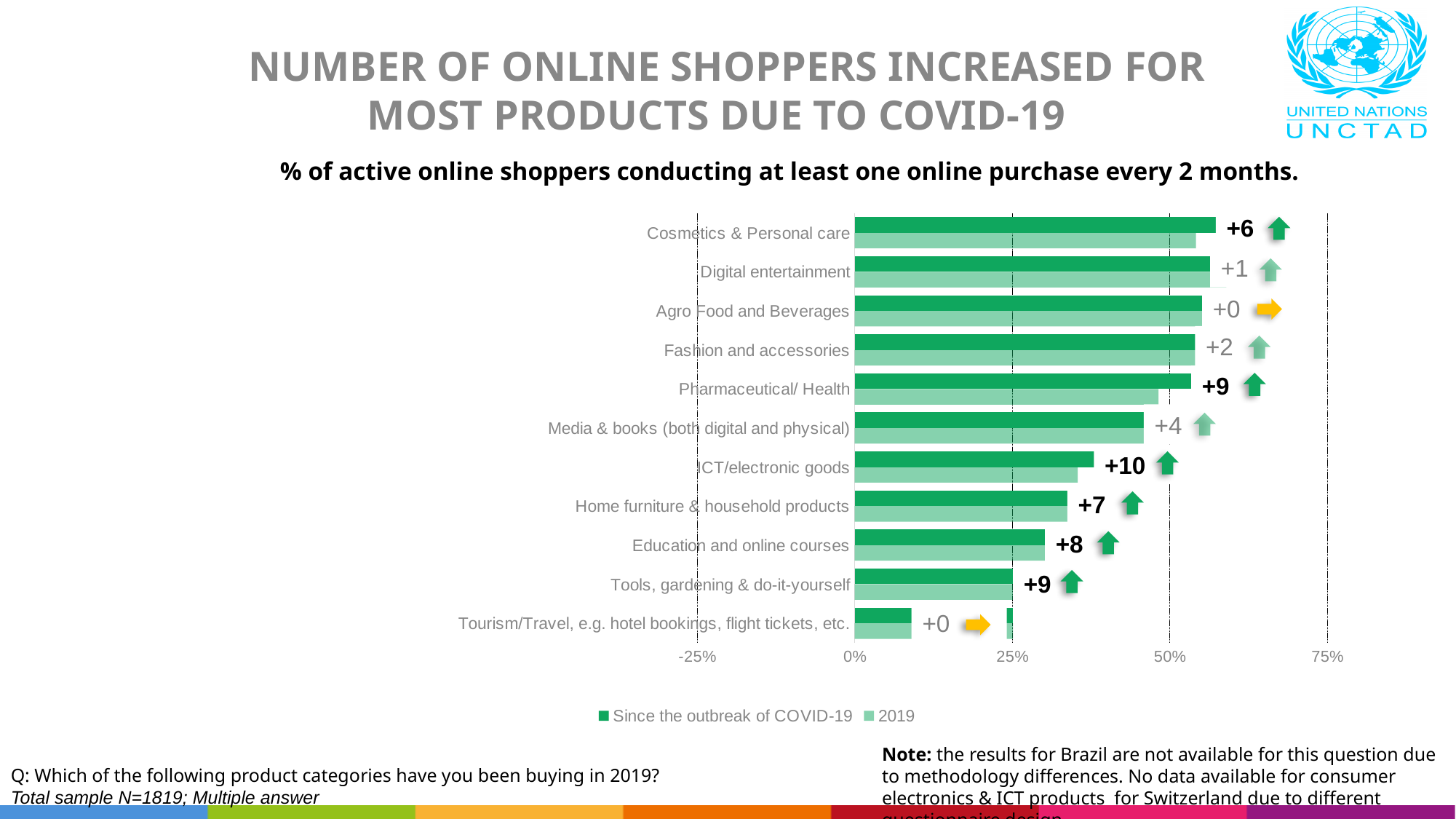
Is the 'Since the outbreak of COVID-19' value for Tourism/Travel greater or less than 25%? less Which product category shows the largest printed increase? ICT/electronic goods How many product categories are plotted on the chart? 11 Which is larger: the 'Since the outbreak of COVID-19' value for Education and online courses or for Tourism/Travel? Education and online courses What change label is printed next to the bars for ICT/electronic goods? +10 What change label is printed next to the bars for Pharmaceutical/ Health? +9 How many series does the legend list? 2 What are the two series named in the legend? Since the outbreak of COVID-19; 2019 Is the 'Since the outbreak of COVID-19' value for Cosmetics & Personal care greater or less than 50%? greater What kind of chart is shown on the slide? bar chart What change label is printed next to the bars for Agro Food and Beverages? +0 Which product category has the lowest value for 'Since the outbreak of COVID-19'? Tourism/Travel, e.g. hotel bookings, flight tickets, etc.